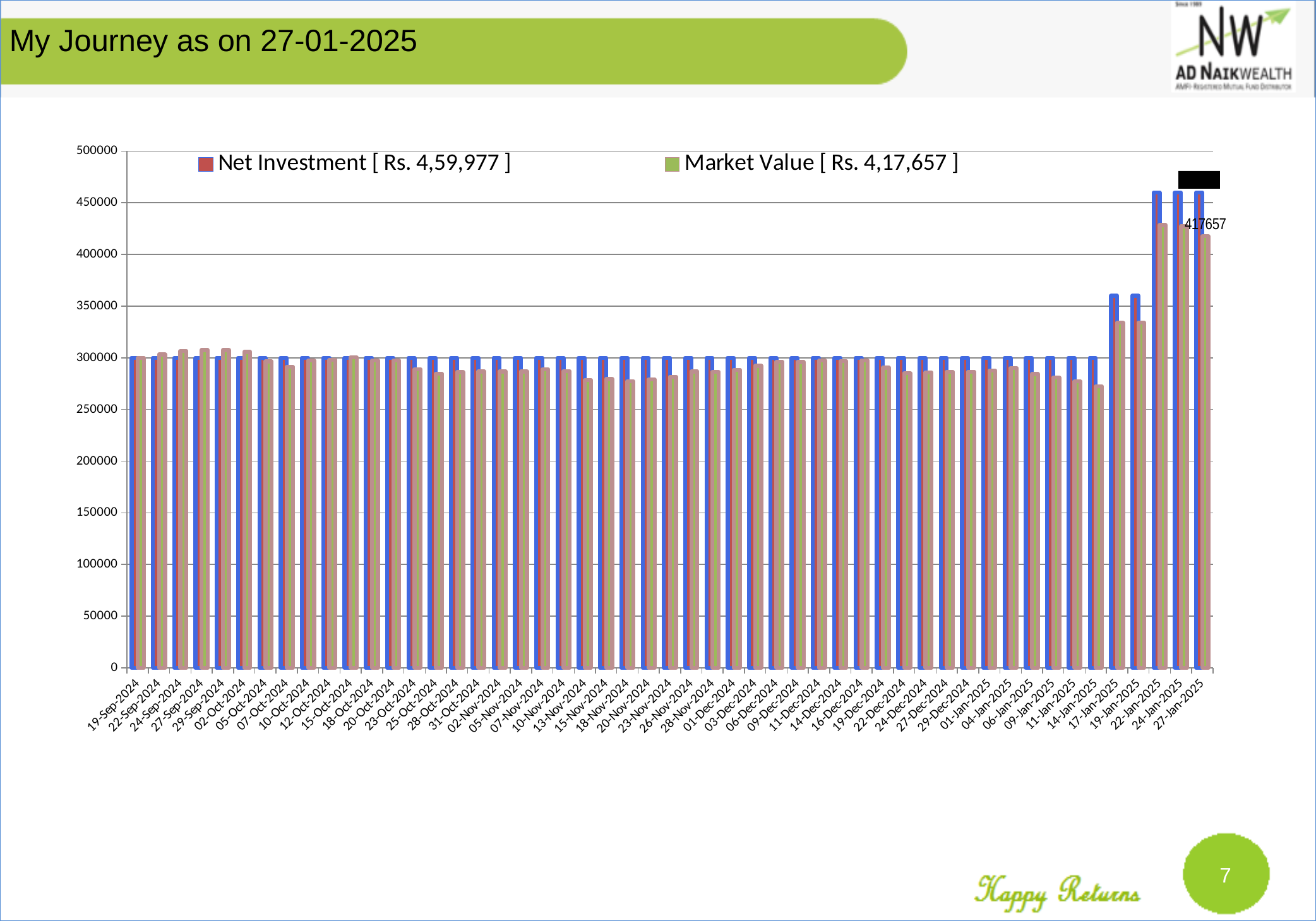
What is the first date shown on the x axis of the chart? 19-Sep-2024 Is the Net Investment value for 27-Jan-2025 greater or less than 450000? greater Is the Market Value for 14-Jan-2025 greater or less than 300000? less On 27-Sep-2024, which is larger: Net Investment or Market Value? Market Value Is the Net Investment value for 17-Jan-2025 greater or less than 350000? greater How many series does the chart legend list? 2 What are the two series named in the chart legend? Net Investment [ Rs. 4,59,977 ] and Market Value [ Rs. 4,17,657 ] What is the Market Value shown by the data label on 27-Jan-2025? 417657 Does the Net Investment series rise or fall overall from 19-Sep-2024 to 27-Jan-2025? rise On 27-Jan-2025, which is larger: Net Investment or Market Value? Net Investment What kind of chart is shown on the slide? bar chart